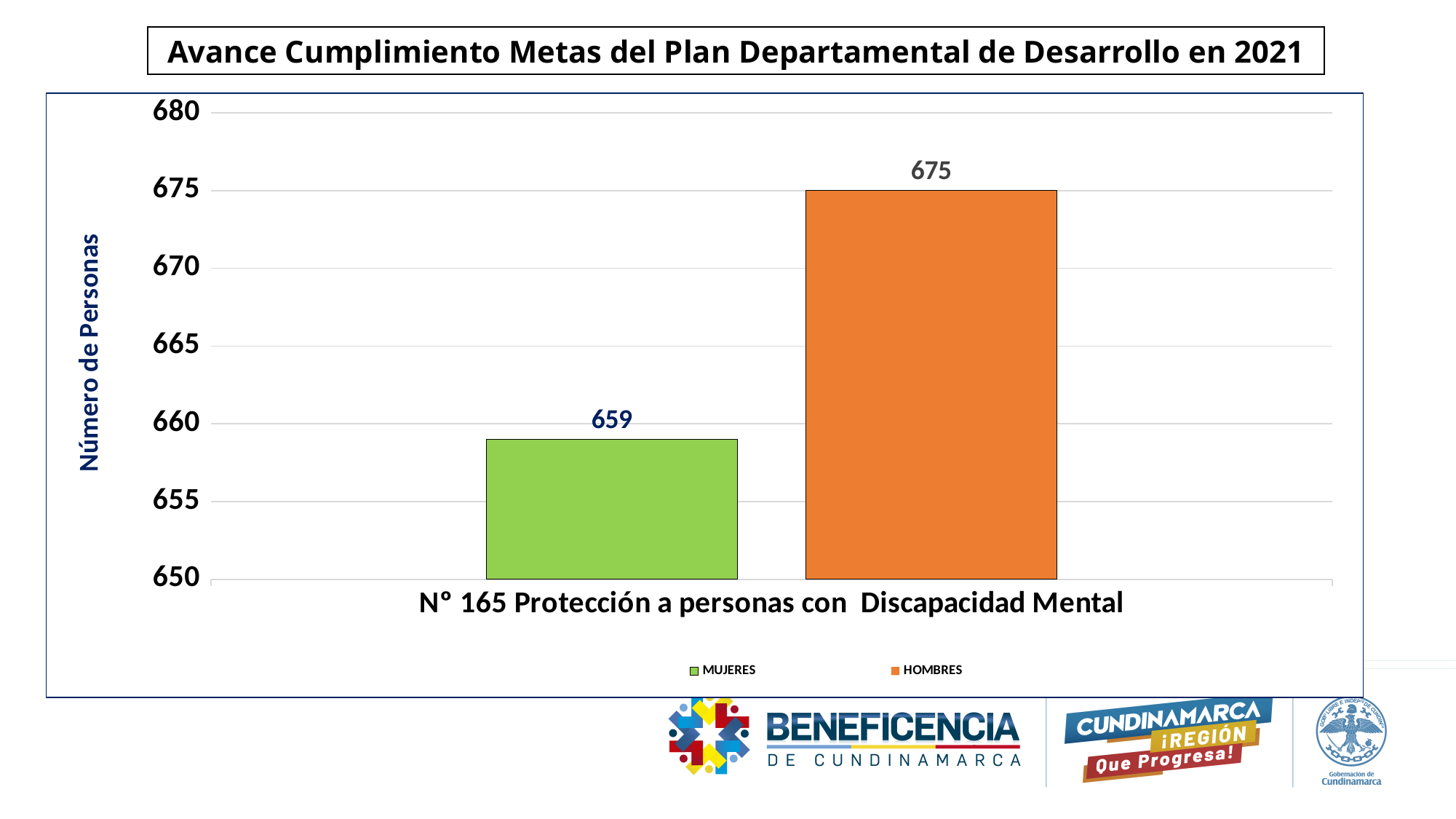
Is the value for MUJERES greater or less than 660? less What is the label on the vertical axis? Número de Personas What kind of chart is shown on the slide? bar chart How many series does the legend list? 2 What is the value for MUJERES? 659 Is the value for HOMBRES greater or less than 670? greater What is the difference between the HOMBRES value and the MUJERES value? 16 What colour is the HOMBRES bar? orange What is the value for HOMBRES? 675 What is the total of the MUJERES and HOMBRES values? 1334 Which series has the higher value, MUJERES or HOMBRES? HOMBRES Which series has the lower value? MUJERES